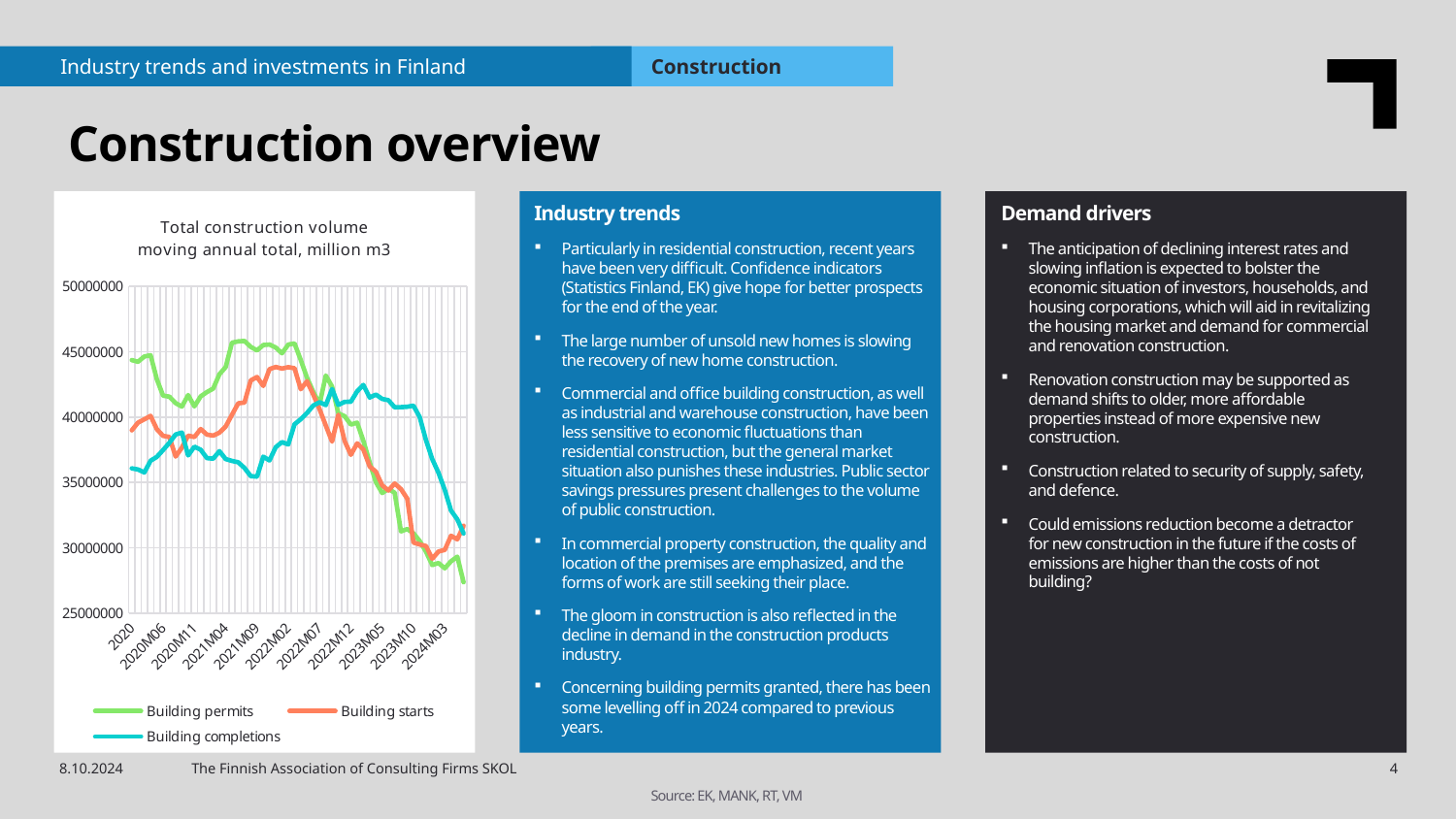
Overall, do the Building permits values rise or fall from 2020 to 2024M03? fall Which series is drawn in green in the chart? Building permits How many series does the chart legend list? 3 Is the value for Building permits at 2020 greater or less than 40000000? greater At 2020, which is larger: Building permits or Building completions? Building permits What is the title of the chart? Total construction volume moving annual total, million m3 Is the value for Building permits at 2024M03 greater or less than 30000000? less What kind of chart is shown on the slide? line chart Which series has the highest value at the start of the period (2020)? Building permits Is the value for Building completions at 2020 greater or less than 40000000? less Which series has the lowest value at the end of the period (2024M03)? Building permits